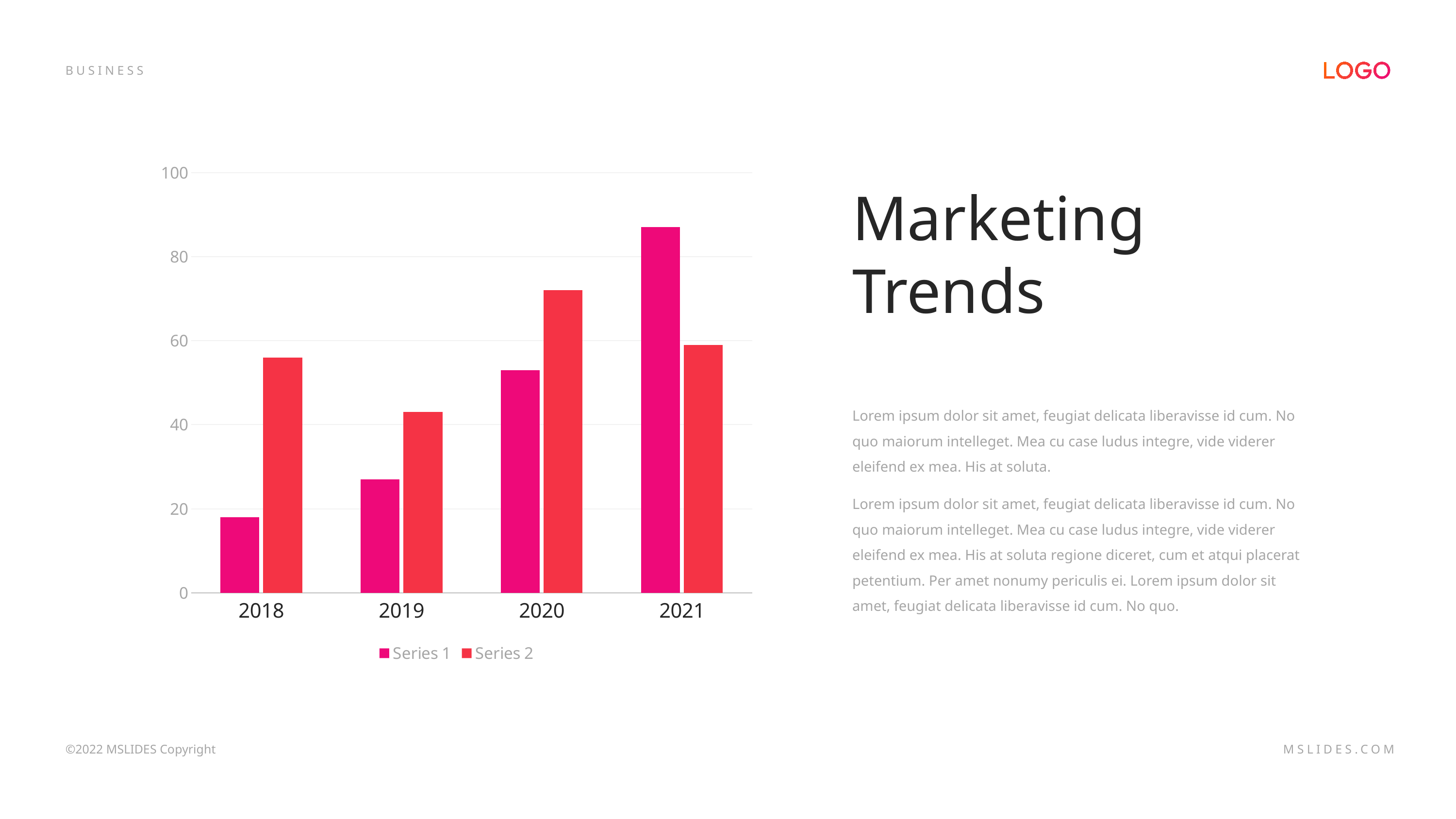
How many series does the legend list? 2 Do the Series 1 values rise or fall from 2018 to 2021? rise In 2018, which is larger, Series 1 or Series 2? Series 2 Which year has the lowest Series 2 value? 2019 What kind of chart is shown on the slide? bar chart Which year has the highest Series 1 value? 2021 Which year has the lowest Series 1 value? 2018 How many years are shown on the x axis? 4 Is the Series 1 value for 2018 greater or less than 20? less Is the Series 1 value for 2021 greater or less than 80? greater Is the Series 2 value for 2020 greater or less than 60? greater Which year has the highest Series 2 value? 2020